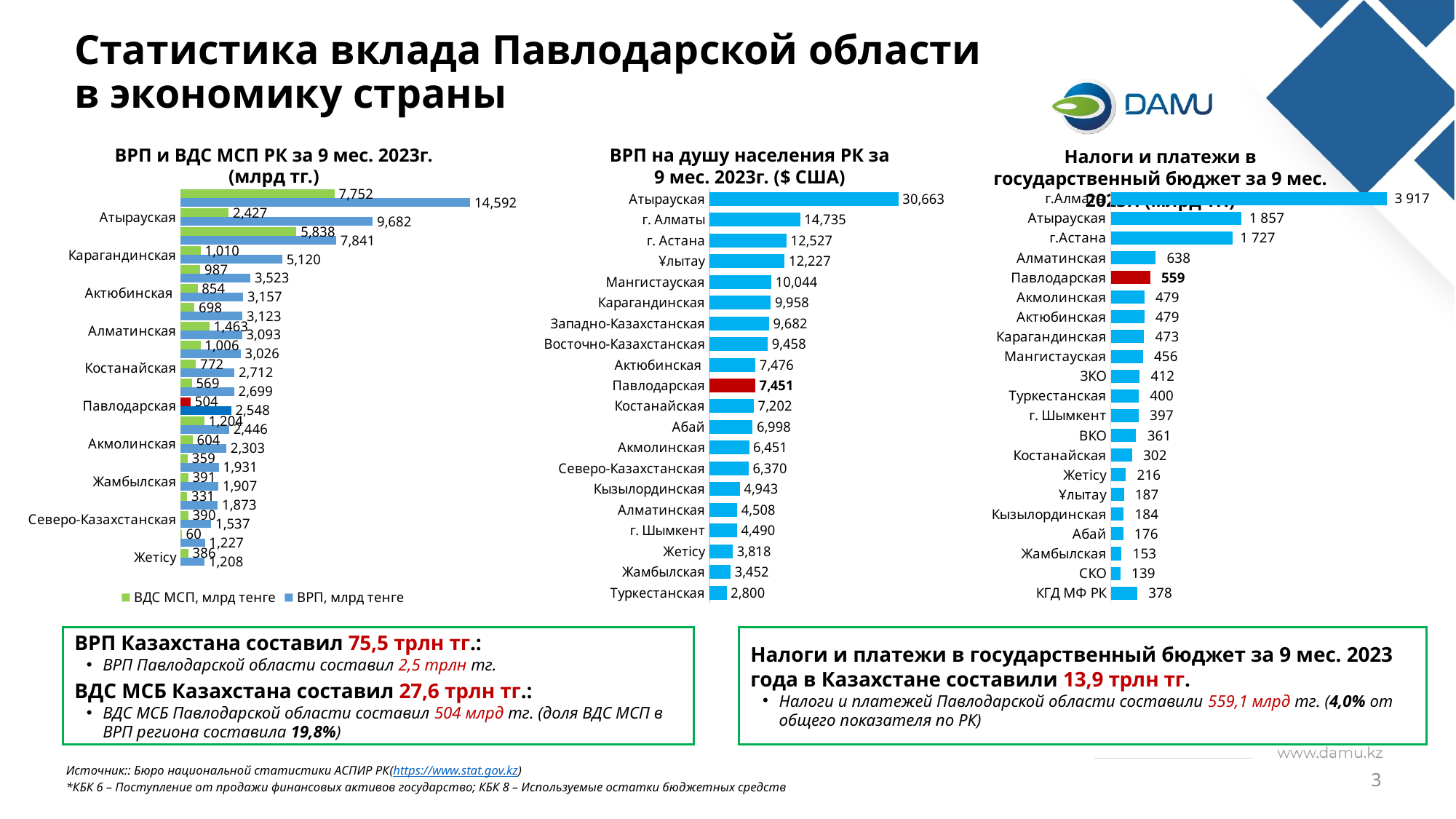
In the chart 'Налоги и платежи в государственный бюджет за 9 мес. 2023г.', what is the value for Павлодарская? 559 In the chart 'ВРП на душу населения РК за 9 мес. 2023г. ($ США)', what is the value for Павлодарская? 7,451 In the chart 'Налоги и платежи в государственный бюджет за 9 мес. 2023г.', which is larger: Атырауская or г.Астана? Атырауская In the chart 'ВРП и ВДС МСП РК за 9 мес. 2023г. (млрд тг.)', how many series does the legend list? 2 In the chart 'Налоги и платежи в государственный бюджет за 9 мес. 2023г.', which category has the highest value? г.Алматы In the chart 'ВРП на душу населения РК за 9 мес. 2023г. ($ США)', what is the difference between г. Алматы and г. Астана? 2,208 In the chart 'ВРП на душу населения РК за 9 мес. 2023г. ($ США)', how many regions are plotted? 20 In the chart 'ВРП на душу населения РК за 9 мес. 2023г. ($ США)', which region has the highest value? Атырауская What type of chart is 'ВРП на душу населения РК за 9 мес. 2023г. ($ США)'? Bar chart In the chart 'Налоги и платежи в государственный бюджет за 9 мес. 2023г.', what is the difference between Алматинская and Павлодарская? 79 In the chart 'ВРП и ВДС МСП РК за 9 мес. 2023г. (млрд тг.)', what is the ВДС МСП value for Павлодарская? 504 In the chart 'ВРП на душу населения РК за 9 мес. 2023г. ($ США)', which region has the lowest value? Туркестанская